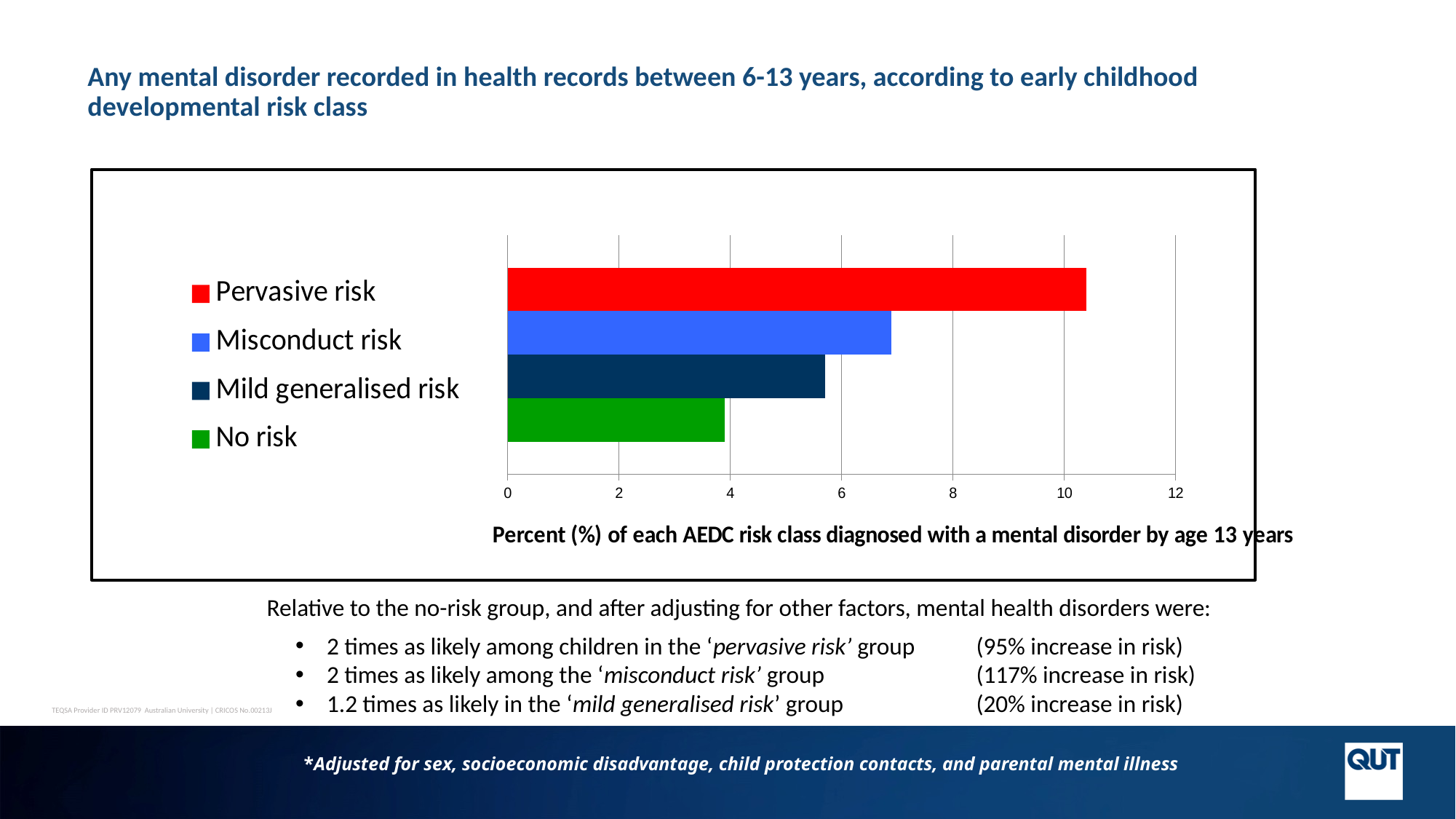
Which risk class has the lowest percentage diagnosed with a mental disorder by age 13 years? No risk What is the label on the horizontal axis of the chart? Percent (%) of each AEDC risk class diagnosed with a mental disorder by age 13 years How many series does the legend list? 4 Which risk class has the highest percentage diagnosed with a mental disorder by age 13 years? Pervasive risk What colour is the bar for Pervasive risk? red Is the value for Misconduct risk greater or less than 6? greater Is the value for Mild generalised risk greater or less than 6? less What kind of chart is shown on the slide? bar chart Is the value for Pervasive risk greater or less than 10? greater Which is larger, the value for Misconduct risk or the value for Mild generalised risk? Misconduct risk Which is larger, the value for No risk or the value for Pervasive risk? Pervasive risk